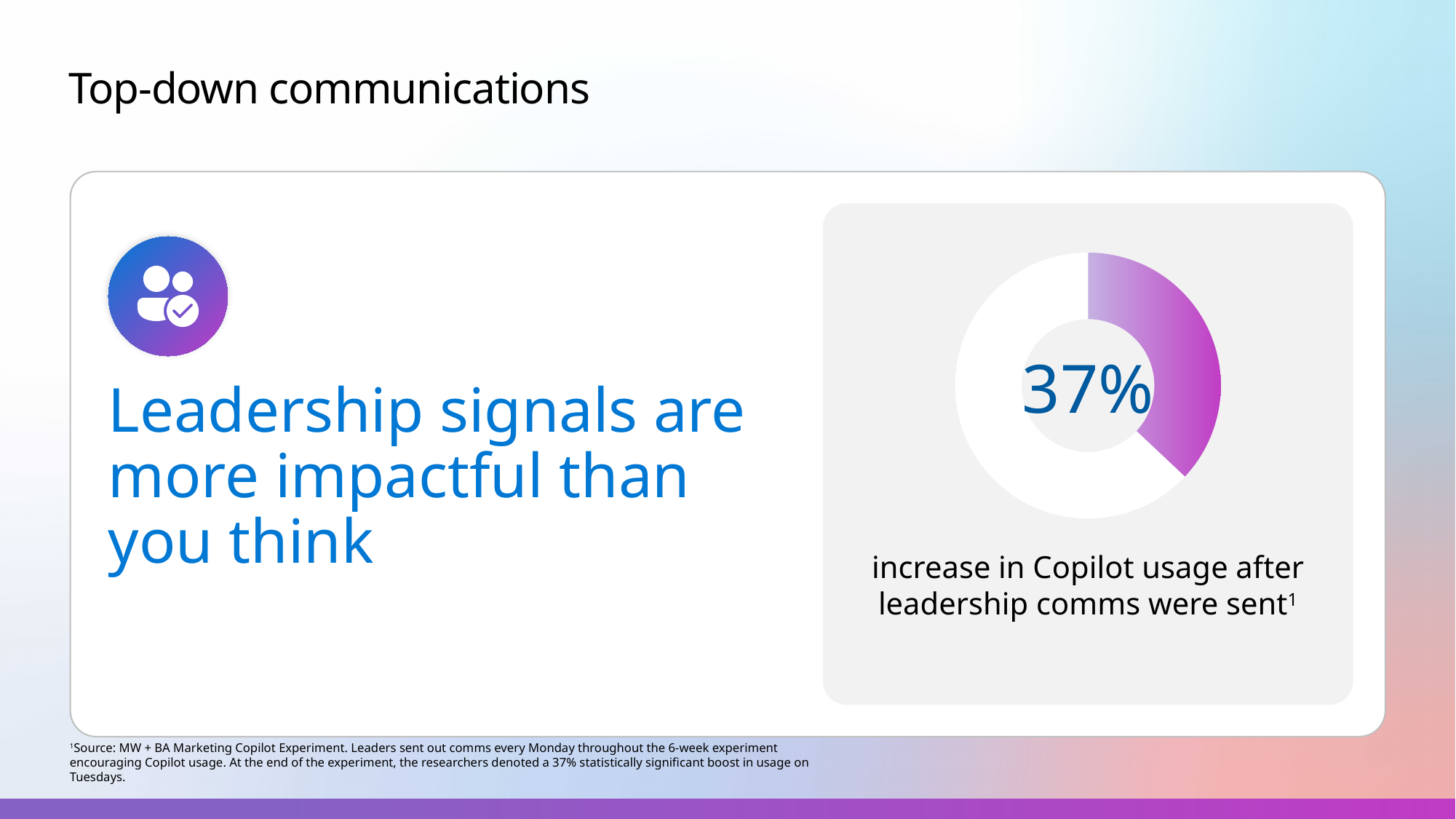
What share of the donut chart is left unfilled (white)? 63% What percentage is displayed in the centre of the donut chart? 37% How many segments does the donut chart have? 2 What share of the donut chart is filled by the coloured segment? 37% What does the 37% in the donut chart represent? Increase in Copilot usage after leadership comms were sent Is the filled portion of the donut chart greater or less than half of the ring? less What kind of chart is shown on the slide? Donut (pie) chart What colour is the filled segment of the donut chart? Purple/magenta